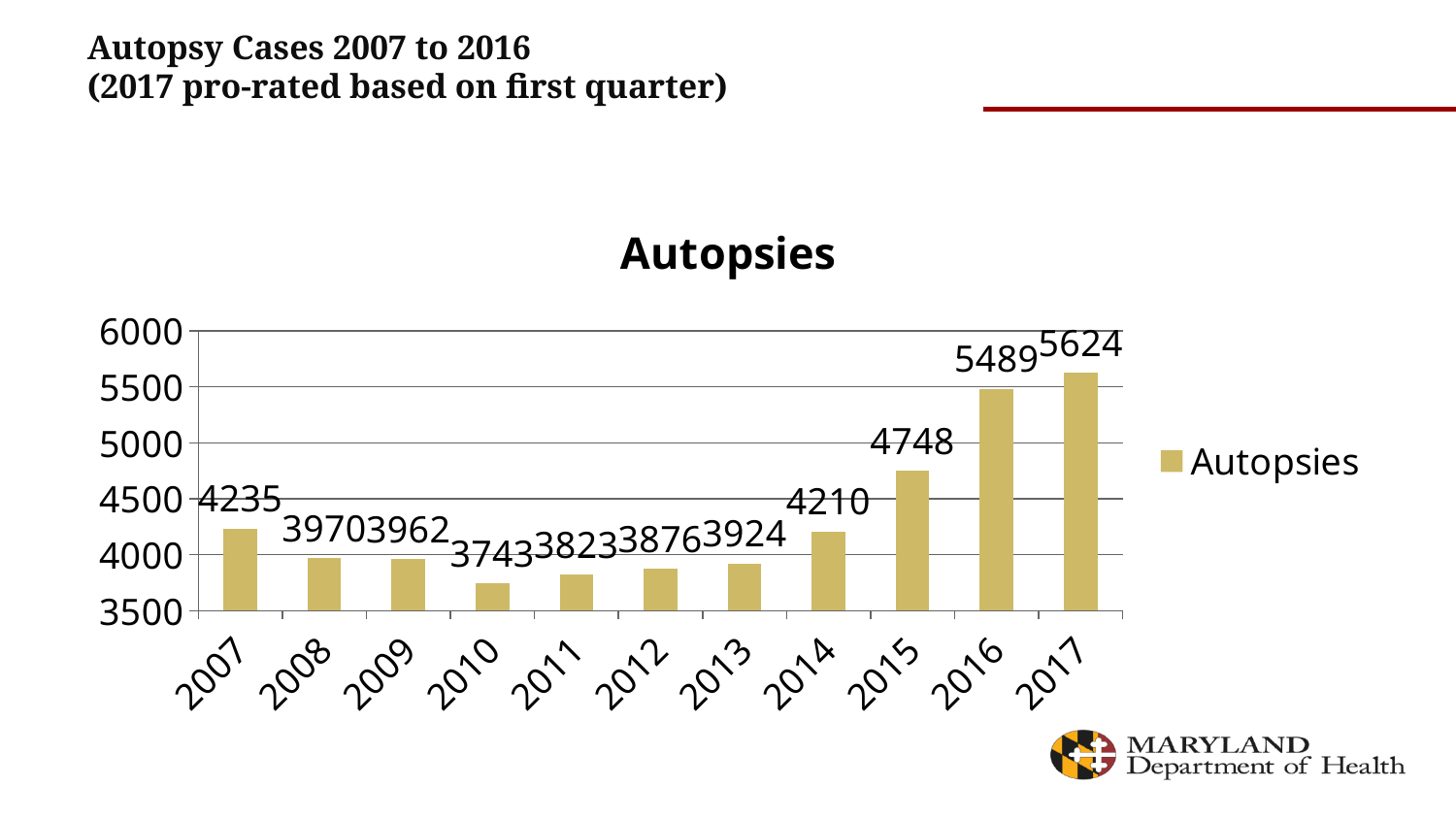
What is the number of autopsies shown for 2016? 5489 Which year has more autopsies, 2008 or 2013? 2008 Is the value for 2015 greater or less than 4500? greater What is the difference between the autopsies in 2017 and 2016? 135 What kind of chart is shown on the slide? Bar chart Which year has the highest number of autopsies? 2017 What is the difference between the autopsies in 2015 and 2014? 538 What is the number of autopsies shown for 2010? 3743 Do the autopsy values rise or fall from 2010 to 2017? Rise What is the number of autopsies shown for 2007? 4235 How many years are shown on the x axis of the chart? 11 Which year has the lowest number of autopsies? 2010